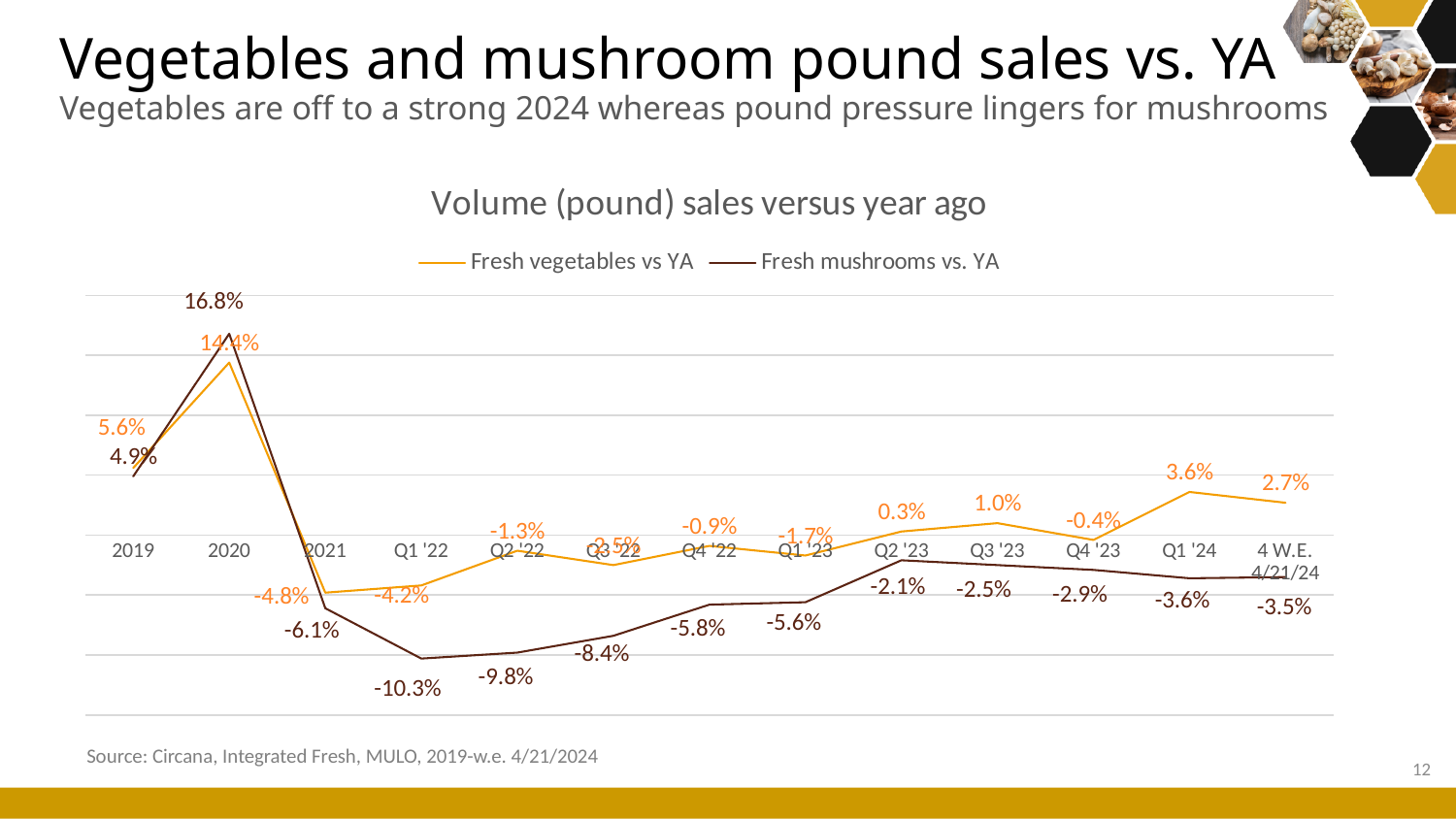
What is the value for Fresh vegetables vs YA in Q2 '23? 0.3% How many series does the legend list? 2 In which period is the Fresh vegetables vs YA value highest? 2020 In Q4 '23, which series has the larger value, Fresh vegetables vs YA or Fresh mushrooms vs. YA? Fresh vegetables vs YA How many time periods are plotted along the x axis? 13 What is the value for Fresh mushrooms vs. YA for 4 W.E. 4/21/24? -3.5% What is the value for Fresh mushrooms vs. YA in 2020? 16.8% In which period is the Fresh mushrooms vs. YA value lowest? Q1 '22 In 2020, how many percentage points higher is Fresh mushrooms vs. YA than Fresh vegetables vs YA? 2.4 percentage points What is the value for Fresh vegetables vs YA in Q1 '24? 3.6% What is the title of the chart? Volume (pound) sales versus year ago What kind of chart is shown on the slide? Line chart